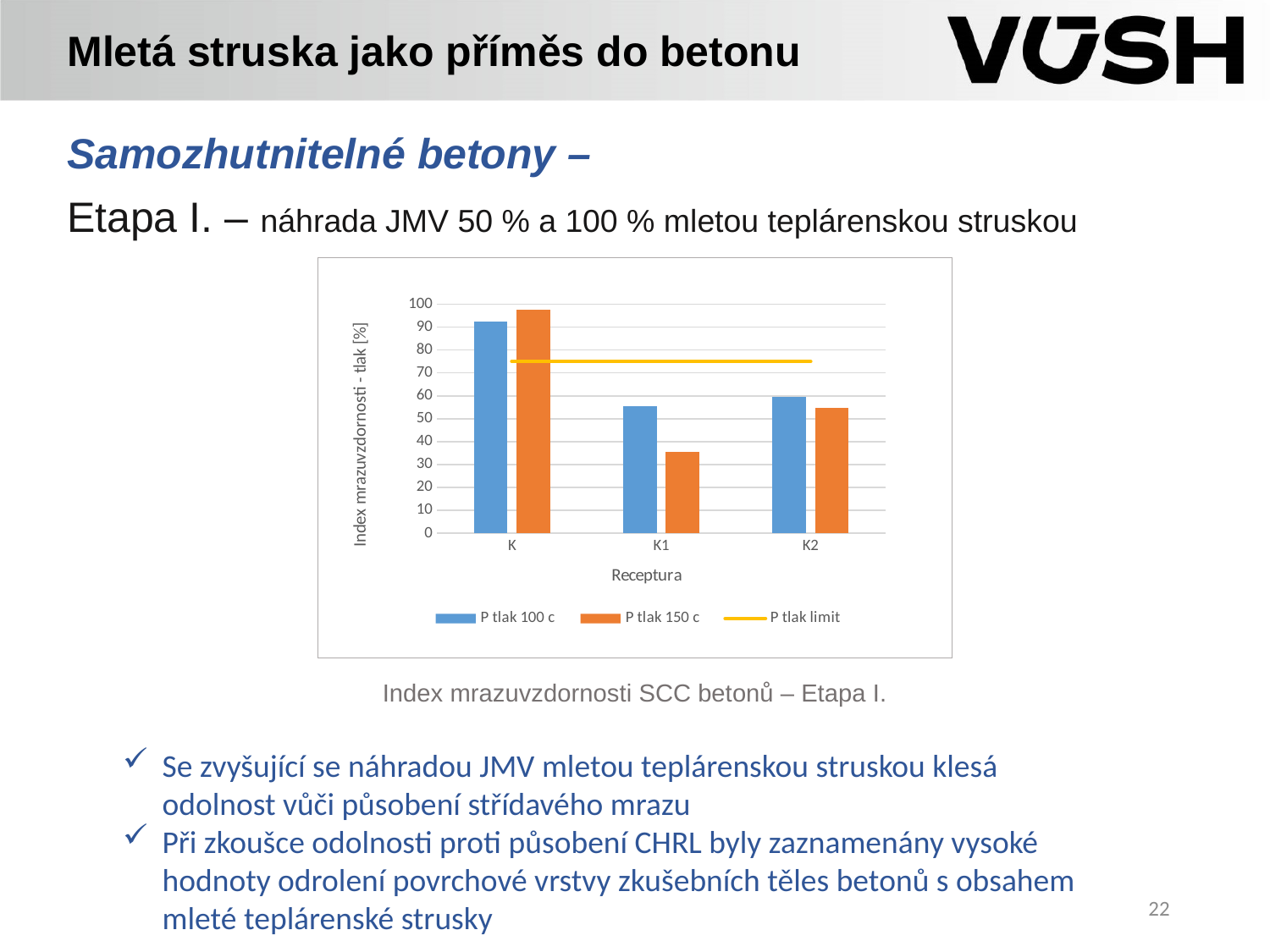
What is the title of the x axis of the chart? Receptura Is the P tlak 100 c value for K2 greater or less than 50? greater Which category has the highest value for the P tlak 100 c series? K Which category has the lowest value for the P tlak 150 c series? K1 For category K1, which series has the larger value: P tlak 100 c or P tlak 150 c? P tlak 100 c Which category has a larger P tlak 100 c value: K or K1? K What kind of chart is shown on the slide? bar chart Is the P tlak 150 c value for K1 greater or less than 40? less How many categories are shown on the x axis of the chart? 3 How many series does the chart legend list? 3 Is the P tlak 100 c value for K greater or less than 80? greater